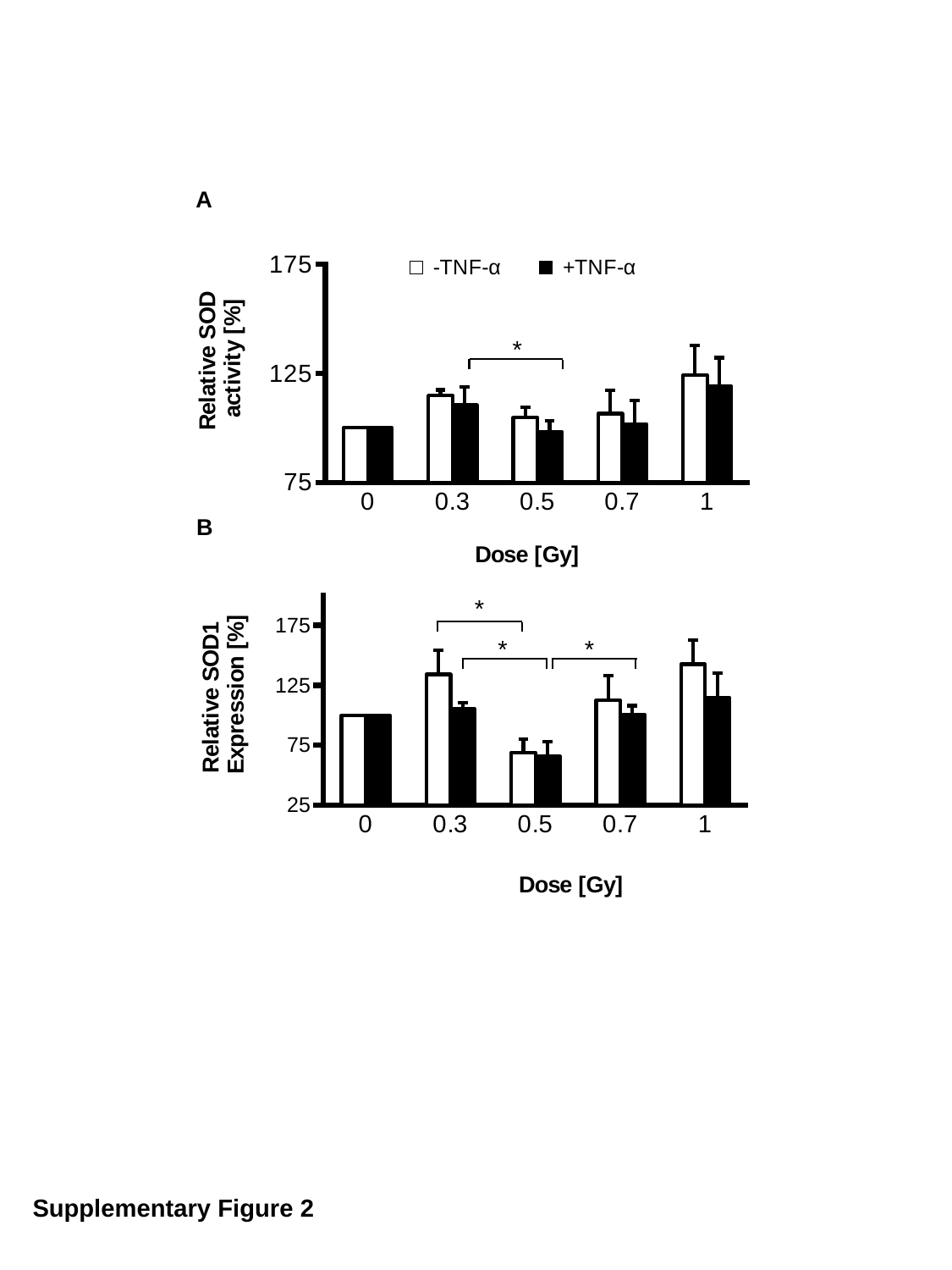
In chart A, is the -TNF-α value at dose 0.3 greater or less than 125? less What kind of chart is chart A (Relative SOD activity)? bar chart What is the x-axis title of chart B? Dose [Gy] In chart B, at which dose is the -TNF-α bar highest? 1 How many series does the legend of chart A list? 2 In chart B, is the -TNF-α value at dose 0.3 greater or less than 125? greater In chart B, at which dose is the -TNF-α bar lowest? 0.5 How many dose categories are shown on the x axis of chart B (Relative SOD1 Expression)? 5 In chart A, which is larger for -TNF-α: the bar at dose 0.3 or the bar at dose 0.5? 0.3 In chart B, which is larger at dose 0.3: the -TNF-α bar or the +TNF-α bar? -TNF-α In chart B, is the +TNF-α value at dose 0.5 greater or less than 75? less In chart A, which series is shown with black bars? +TNF-α